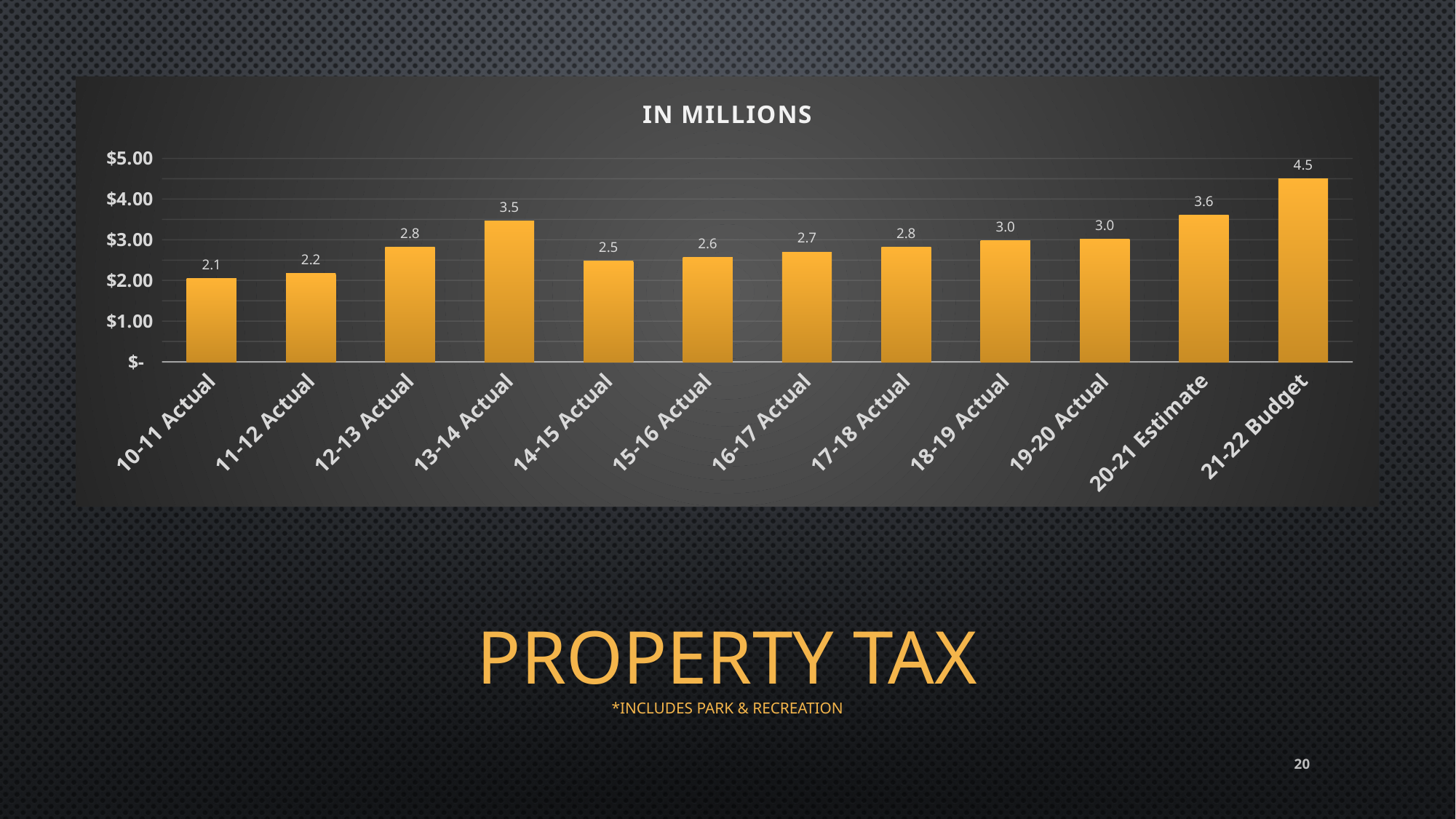
What is the title of the chart? IN MILLIONS Which category has the highest value? 21-22 Budget Which is larger, the value for 13-14 Actual or the value for 18-19 Actual? 13-14 Actual What is the difference between the values for 13-14 Actual and 14-15 Actual? 1.0 What is the difference between the values for 21-22 Budget and 20-21 Estimate? 0.9 Is the value for 21-22 Budget greater or less than $4.00? greater How many categories are shown on the x axis? 12 What is the value for 21-22 Budget? 4.5 What kind of chart is shown on the slide? bar chart Which category has the lowest value? 10-11 Actual What is the value for 13-14 Actual? 3.5 What is the value for 20-21 Estimate? 3.6